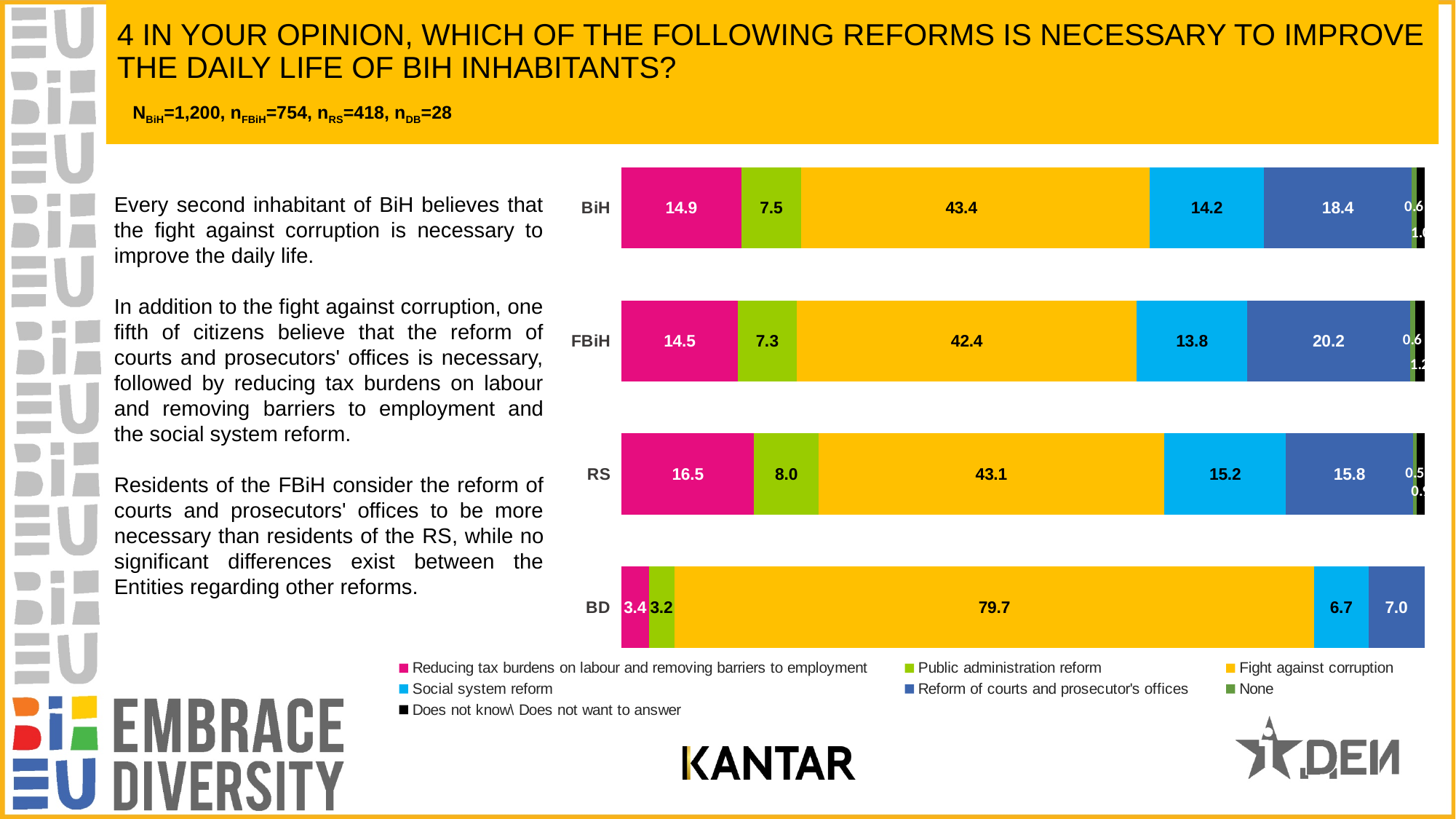
What is the difference between the Reform of courts and prosecutor's offices values for FBiH and RS? 4.4 Which category has the highest value for Fight against corruption? BD What is the value for Reform of courts and prosecutor's offices in the FBiH bar? 20.2 Which is larger: the Public administration reform value for RS or for FBiH? RS What is the value for Social system reform in the RS bar? 15.2 Which category has the lowest value for Reducing tax burdens on labour and removing barriers to employment? BD How many series does the legend list? 7 What is the value for Fight against corruption in the BiH bar? 43.4 Which colour represents Fight against corruption in the chart? Yellow What kind of chart is shown on the slide? Stacked bar chart What is the value for Fight against corruption in the BD bar? 79.7 How many categories (bars) are shown in the chart? 4